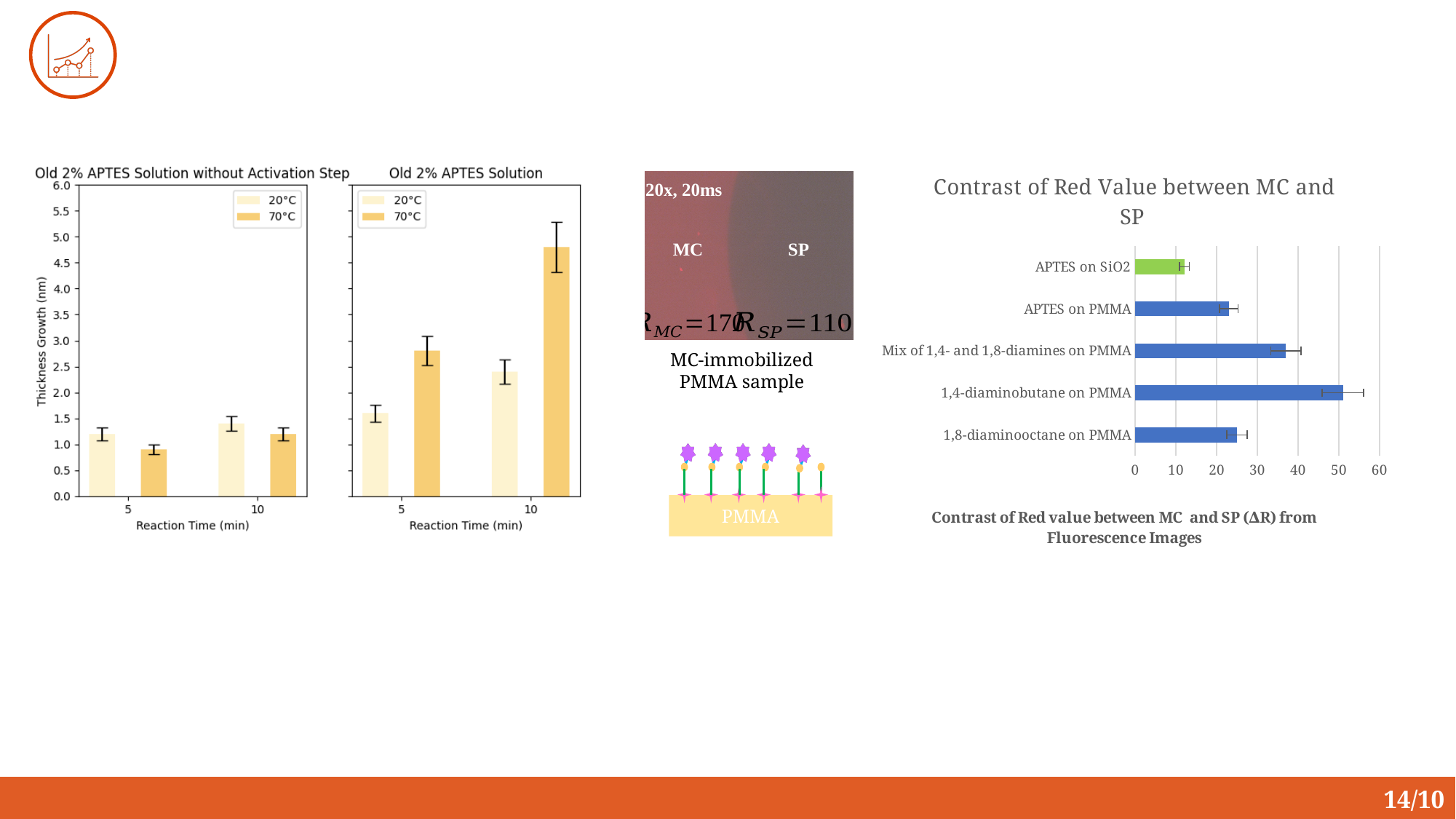
In the 'Contrast of Red Value between MC and SP' chart, is the value for 1,4-diaminobutane on PMMA greater or less than 40? greater In the 'Contrast of Red Value between MC and SP' chart, which category has the lowest value? APTES on SiO2 In the 'Old 2% APTES Solution' chart, how many series does the legend list? 2 What kind of chart is the 'Contrast of Red Value between MC and SP' chart? bar chart In the 'Contrast of Red Value between MC and SP' chart, which is larger: Mix of 1,4- and 1,8-diamines on PMMA or 1,8-diaminooctane on PMMA? Mix of 1,4- and 1,8-diamines on PMMA In the 'Contrast of Red Value between MC and SP' chart, is the value for APTES on SiO2 greater or less than 20? less In the 'Contrast of Red Value between MC and SP' chart, how many categories are plotted? 5 In the 'Old 2% APTES Solution without Activation Step' chart, at 5 min reaction time, which is larger: the 20°C bar or the 70°C bar? 20°C In the 'Contrast of Red Value between MC and SP' chart, which category has the highest value? 1,4-diaminobutane on PMMA What is the y-axis label of the 'Old 2% APTES Solution without Activation Step' chart? Thickness Growth (nm) In the 'Old 2% APTES Solution' chart, which bar is the highest? 70°C at 10 min In the 'Old 2% APTES Solution' chart, is the 70°C value at 10 min greater or less than 4.0? greater